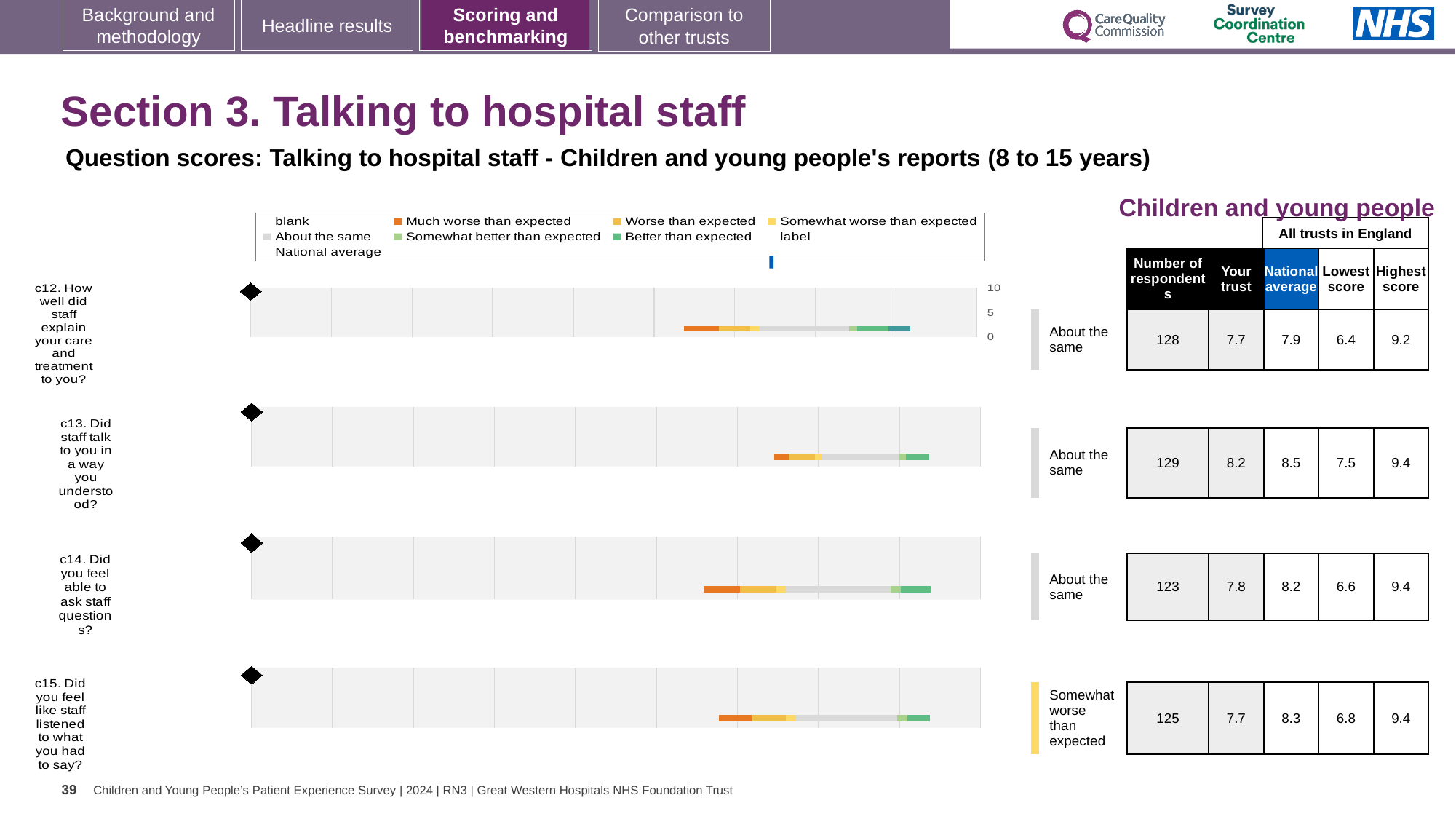
What is the national average score for c15 (Did you feel like staff listened to what you had to say?)? 8.3 How many survey questions (c12 to c15) are plotted on the slide? 4 Which question has the highest 'Your trust' score? c13 What colour does the legend use for 'Much worse than expected'? Orange For c15, what is the difference between the national average and the 'Your trust' score? 0.6 Which question has the lowest 'Lowest score' among all trusts in England? c12 What kind of chart is used to show the question scores for c12 to c15? bar chart What is the 'Your trust' score for c13 (Did staff talk to you in a way you understood?)? 8.2 How many respondents answered c14 (Did you feel able to ask staff questions?)? 123 For c14, which is larger: the 'Your trust' score or the national average? National average What is the highest score among all trusts in England for c12? 9.2 What benchmark category is shown for c15? Somewhat worse than expected